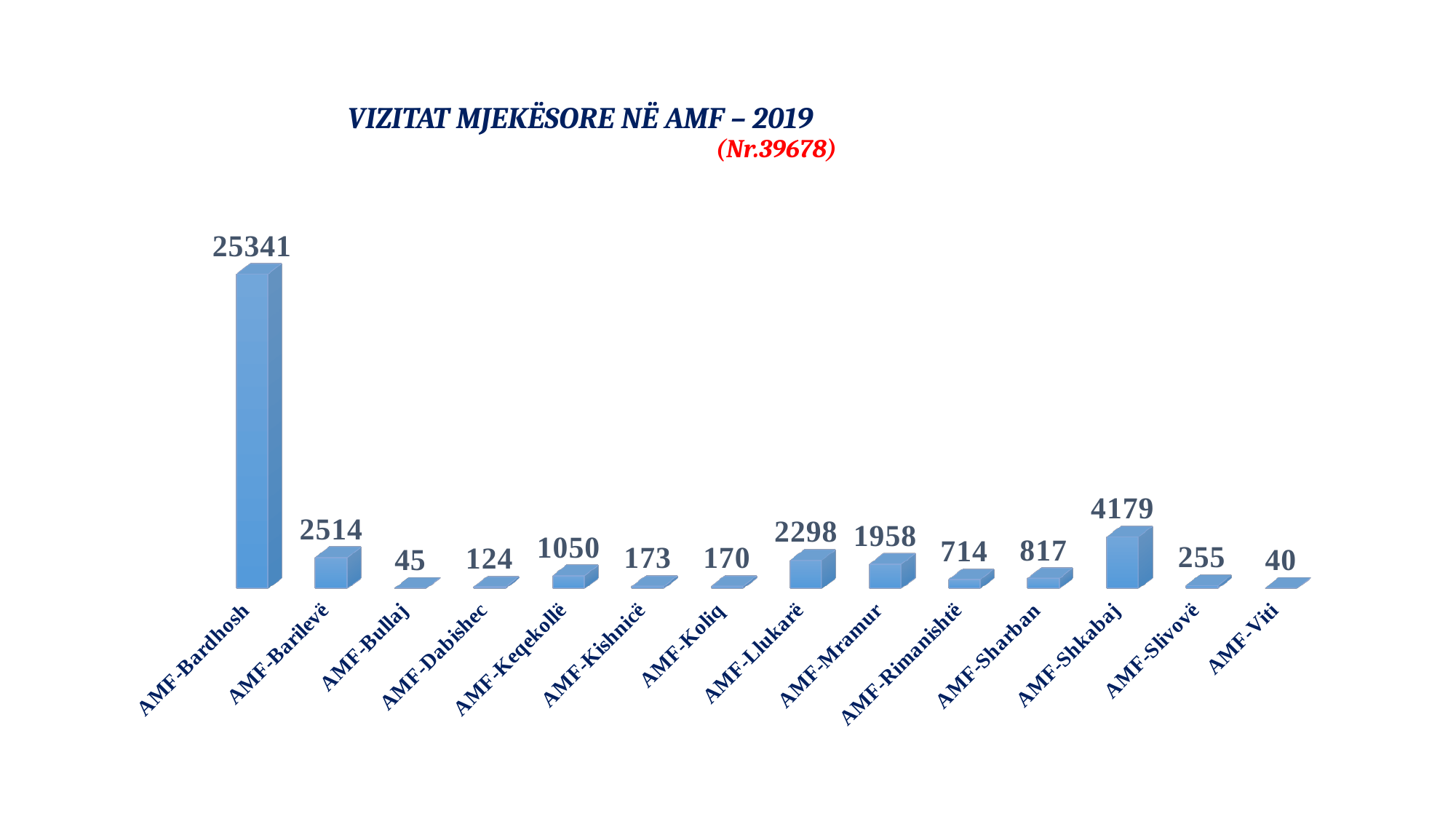
What is the value for AMF-Shkabaj? 4179 Which is larger, the value for AMF-Keqekollë or the value for AMF-Sharban? AMF-Keqekollë Which category has the highest value? AMF-Bardhosh What is the value for AMF-Rimanishtë? 714 How many categories are shown in the chart? 14 What is the value for AMF-Bardhosh? 25341 What kind of chart is shown on the slide? Bar chart What is the difference between the values for AMF-Llukarë and AMF-Mramur? 340 What is the value for AMF-Keqekollë? 1050 What is the difference between the values for AMF-Shkabaj and AMF-Barilevë? 1665 What total number is shown in red under the chart title? Nr.39678 Which category has the lowest value? AMF-Viti